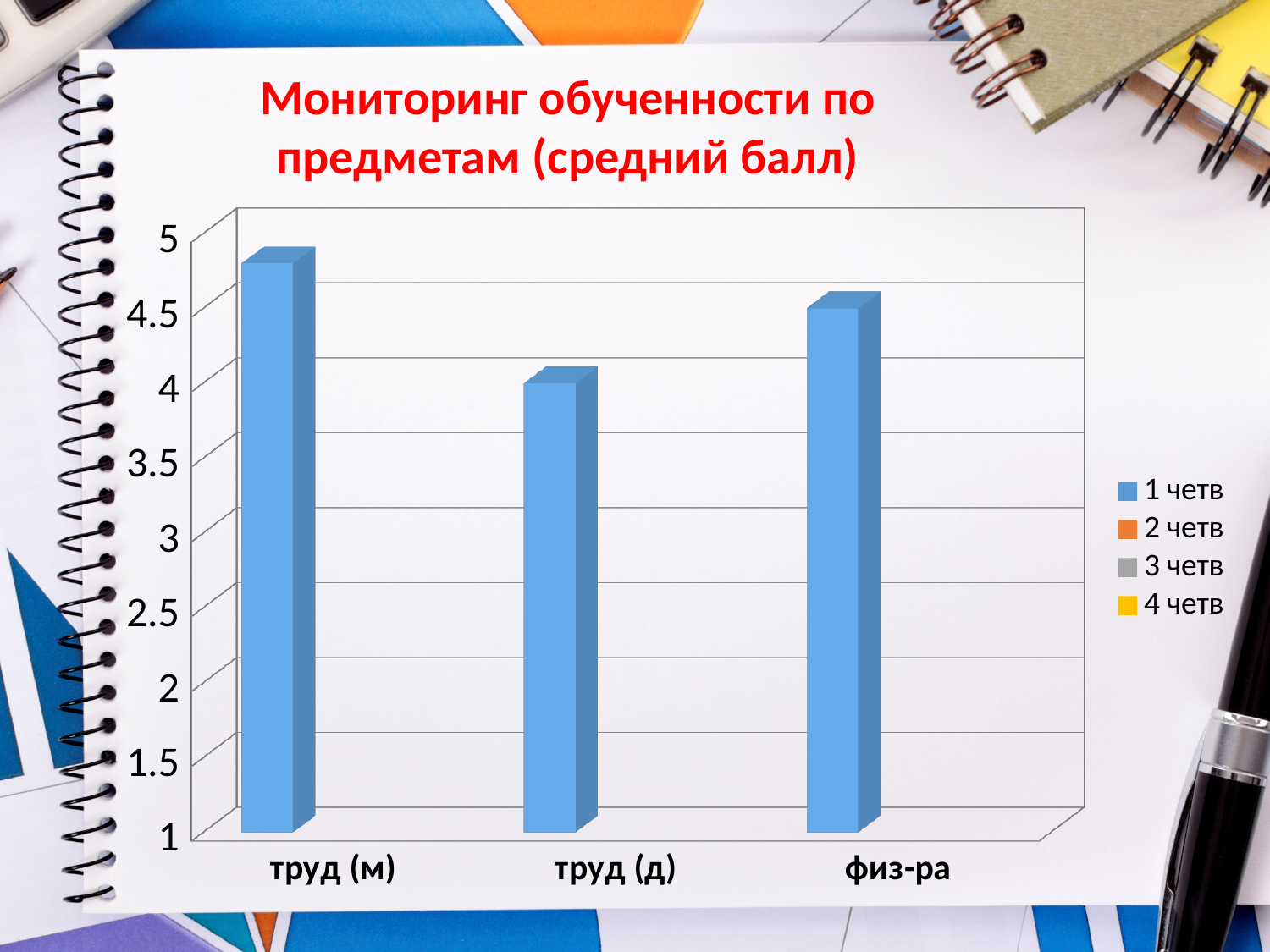
Which is larger, the value for труд (м) or the value for физ-ра? труд (м) Which is larger, the value for физ-ра or the value for труд (д)? физ-ра Which category has the lowest bar in the chart? труд (д) Is the value for труд (м) greater or less than 4.5? greater Which category has the highest bar in the chart? труд (м) How many series does the chart's legend list? 4 Is the value for труд (д) greater or less than 4.5? less What kind of chart is shown on the slide? bar chart How many categories are shown on the x axis of the chart? 3 Is the value for физ-ра greater or less than 4? greater What is the title of the chart on the slide? Мониторинг обученности по предметам (средний балл) Which series in the legend is shown in blue? 1 четв